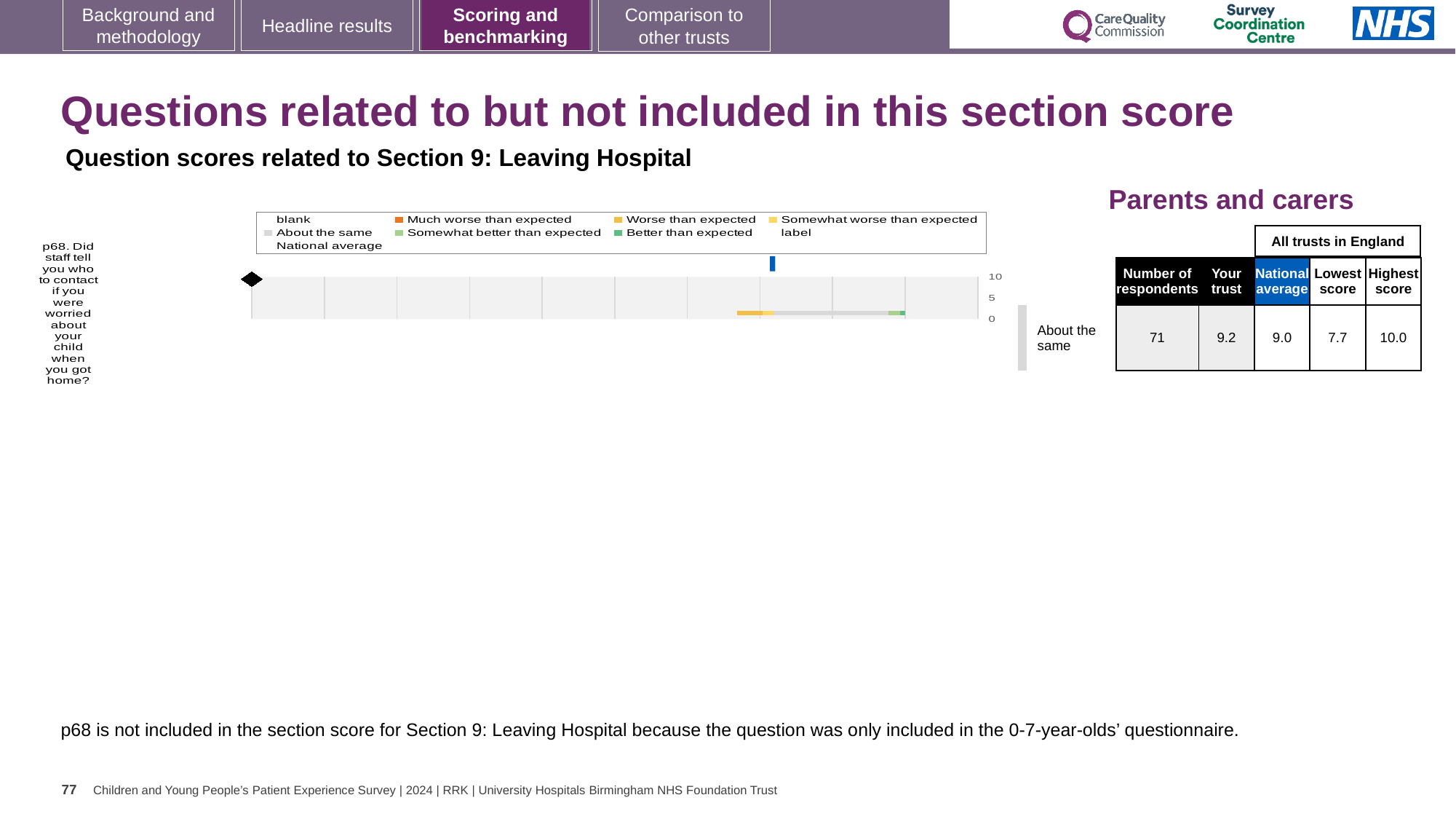
Is the national average for question p68 greater or less than 5 on the chart axis? greater How many respondents answered question p68? 71 What is the 'Your trust' score for question p68? 9.2 What is the lowest score among all trusts in England for question p68? 7.7 Which benchmark category is shown for question p68? About the same What kind of chart is shown for question p68? bar chart What is the difference between the highest score and the lowest score for question p68? 2.3 What is the highest score among all trusts in England for question p68? 10.0 How many survey questions are plotted in the chart? 1 What is the national average score for question p68? 9.0 How many entries does the chart legend list? 9 Which is larger for question p68, the 'Your trust' score or the national average? Your trust